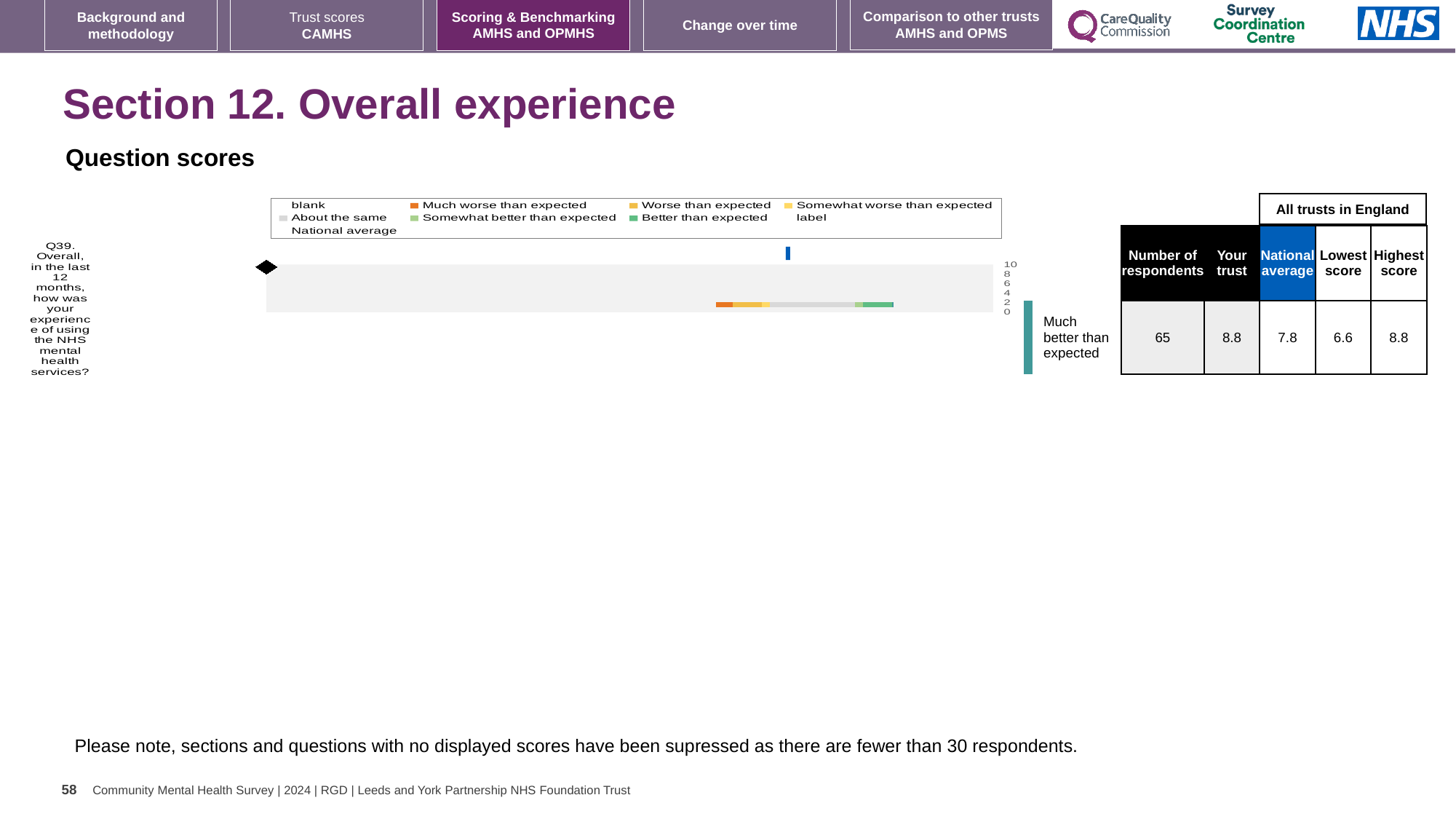
What is the difference between the 'Your trust' score and the national average for Q39? 1.0 What is the national average score for Q39 shown in the table next to the chart? 7.8 How many survey questions are plotted in the chart? 1 Which question number is plotted in the chart? Q39 What is the lowest score among all trusts in England for Q39? 6.6 What is the highest value shown on the chart's axis? 10 What is the highest score among all trusts in England for Q39? 8.8 How many respondents answered Q39? 65 What is the difference between the highest and lowest scores among all trusts in England for Q39? 2.2 What is the 'Your trust' score for Q39 shown in the table next to the chart? 8.8 Which is larger for Q39, the 'Your trust' score or the national average? Your trust What kind of chart is shown on the slide? bar chart